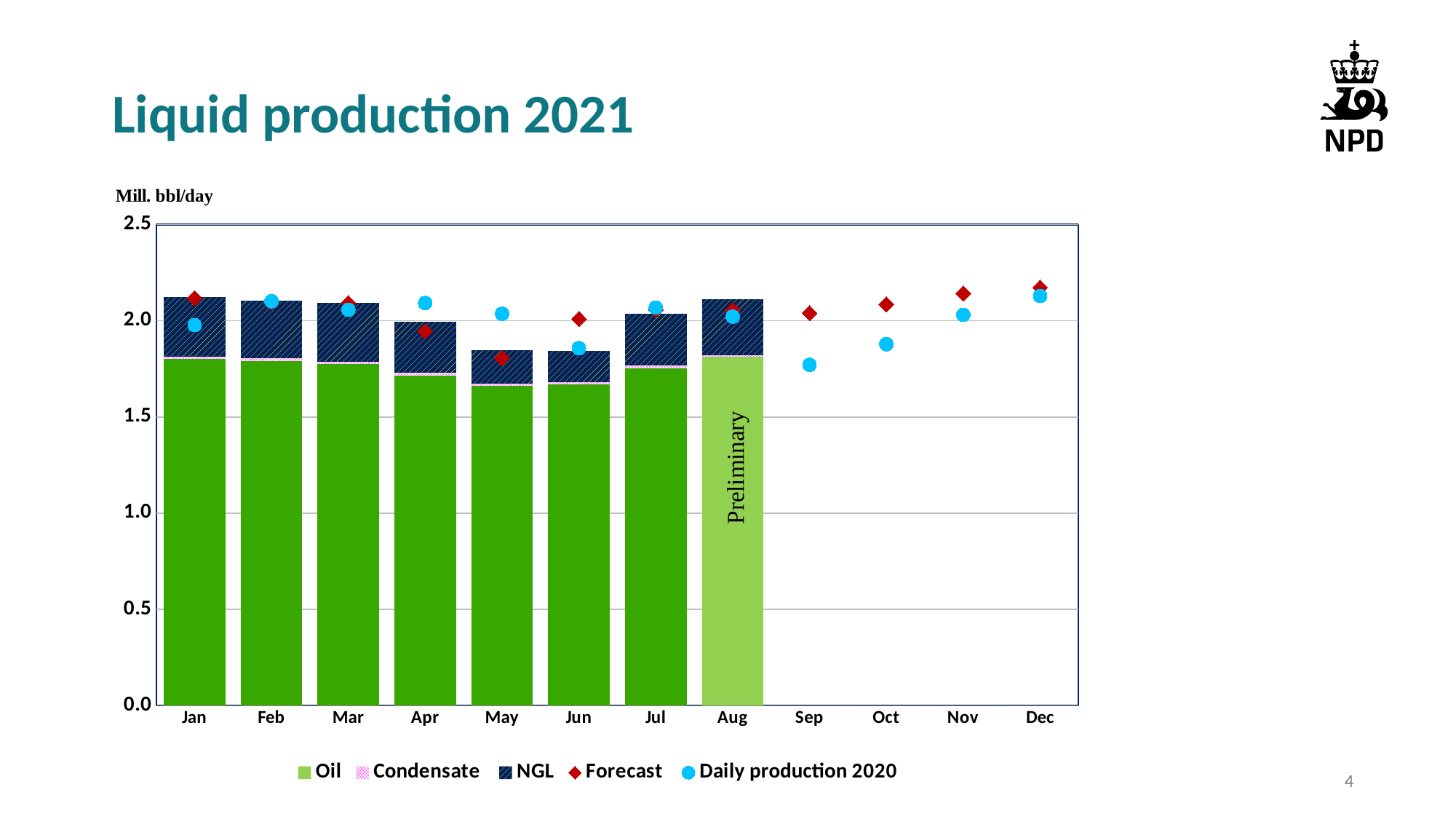
Is the Forecast value for Dec greater or less than 2.0? greater What kind of chart is shown on the slide? bar chart How many series does the legend list? 5 How many months have a stacked bar plotted? 8 Is the Daily production 2020 value for Sep greater or less than 2.0? less Is the total stacked bar for Jan greater or less than 2.0? greater What unit is shown above the y axis? Mill. bbl/day Which month's bar is labelled 'Preliminary'? Aug Which is larger, the total stacked bar for Jan or the total stacked bar for May? Jan Do the Forecast values rise or fall from Sep to Dec? rise How many months are shown on the x axis? 12